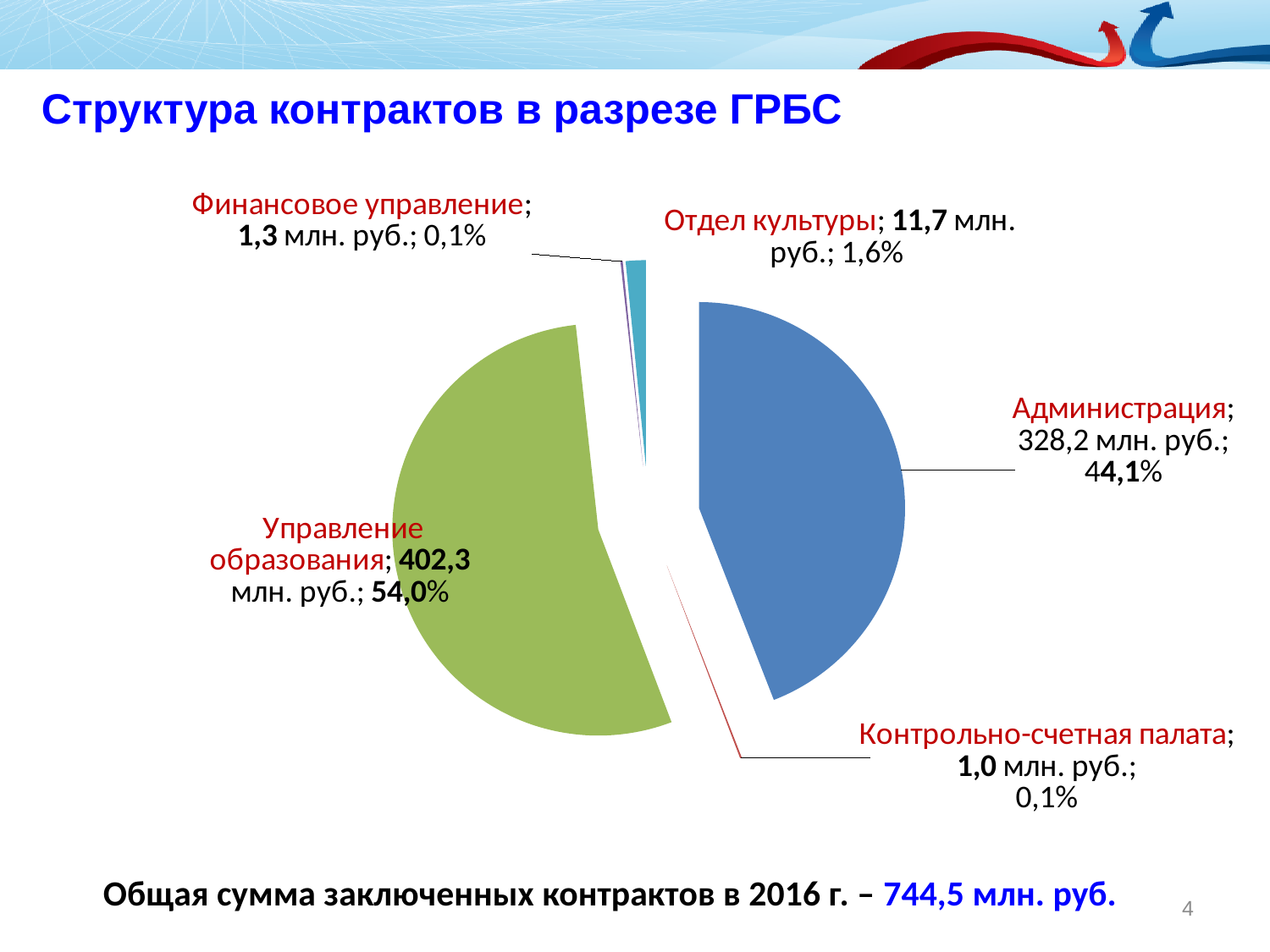
What share of the pie does Управление образования have? 54,0% What share of the pie does Отдел культуры have? 1,6% What is the difference in млн. руб. between Управление образования and Администрация? 74,1 млн. руб. What kind of chart is shown on the slide? pie chart Which category has the smallest value in млн. руб.? Контрольно-счетная палата Which is larger: the value for Финансовое управление or the value for Отдел культуры? Отдел культуры Which category has the largest slice of the pie? Управление образования What is the title of the chart on the slide? Структура контрактов в разрезе ГРБС What is the value for Отдел культуры in млн. руб.? 11,7 млн. руб. What is the total sum of contracts concluded in 2016 stated on the slide? 744,5 млн. руб. How many slices does the pie chart have? 5 What is the value for Администрация in млн. руб.? 328,2 млн. руб.